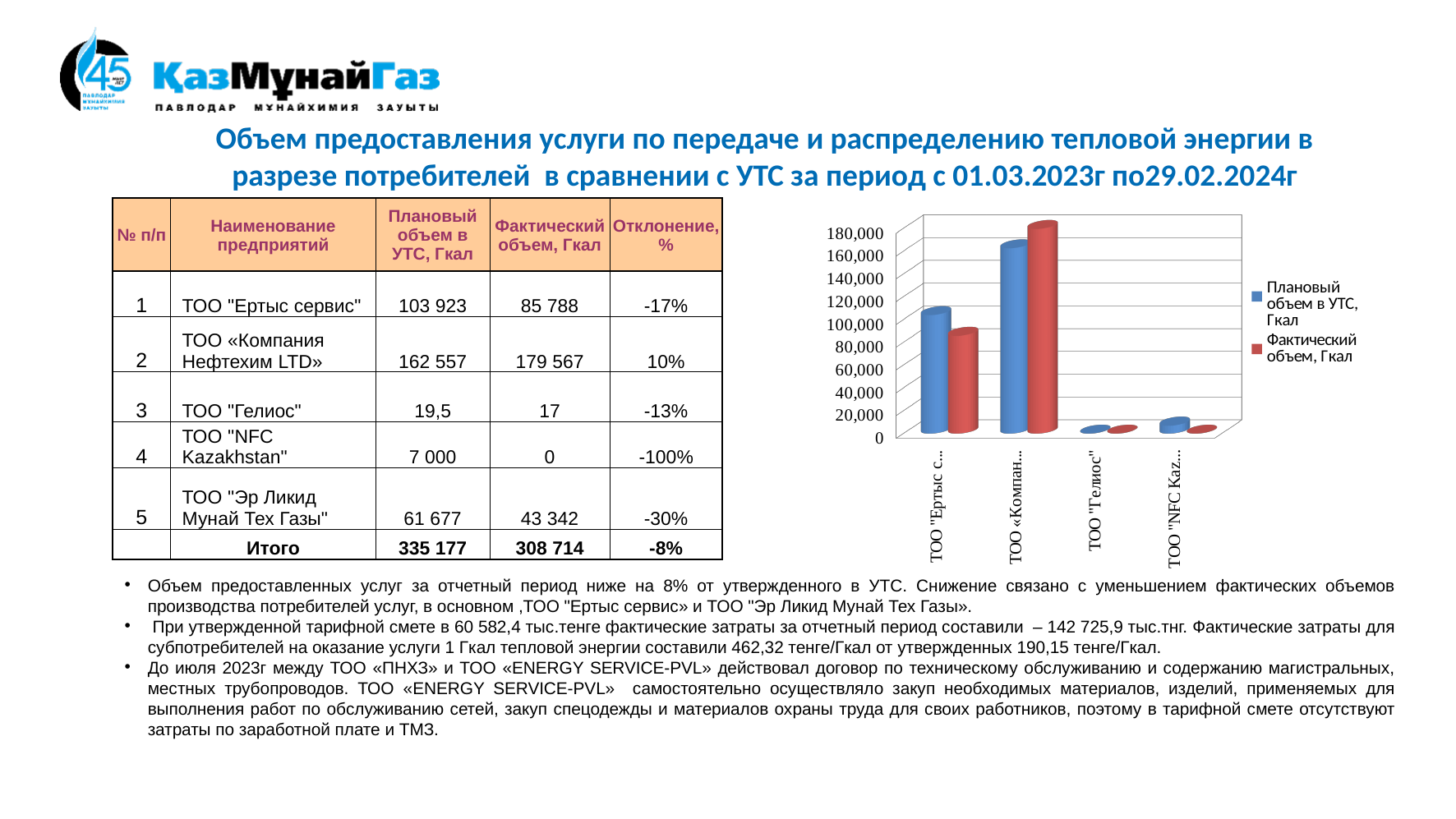
What colour are the bars for the actual volume (Фактический объем, Гкал) series? red For ТОО «Компания Нефтехим LTD», which is larger: the planned volume or the actual volume? actual volume Which enterprise has the highest planned volume (Плановый объем в УТС) on the chart? ТОО «Компания Нефтехим LTD» Is the actual volume for ТОО "Ертыс сервис" greater or less than 100,000? less How many categories (enterprises) are plotted on the chart? 4 How many series does the chart legend list? 2 Which enterprise has the lowest actual volume (Фактический объем) on the chart? ТОО "NFC Kazakhstan" For ТОО "Ертыс сервис", which is larger: the planned volume or the actual volume? planned volume Is the actual volume for ТОО «Компания Нефтехим LTD» greater or less than 160,000? greater Is the planned volume for ТОО "Ертыс сервис" greater or less than 100,000? greater What is the planned volume in УТС for ТОО "Ертыс сервис", as printed in the table? 103 923 What kind of chart is shown on the slide? bar chart